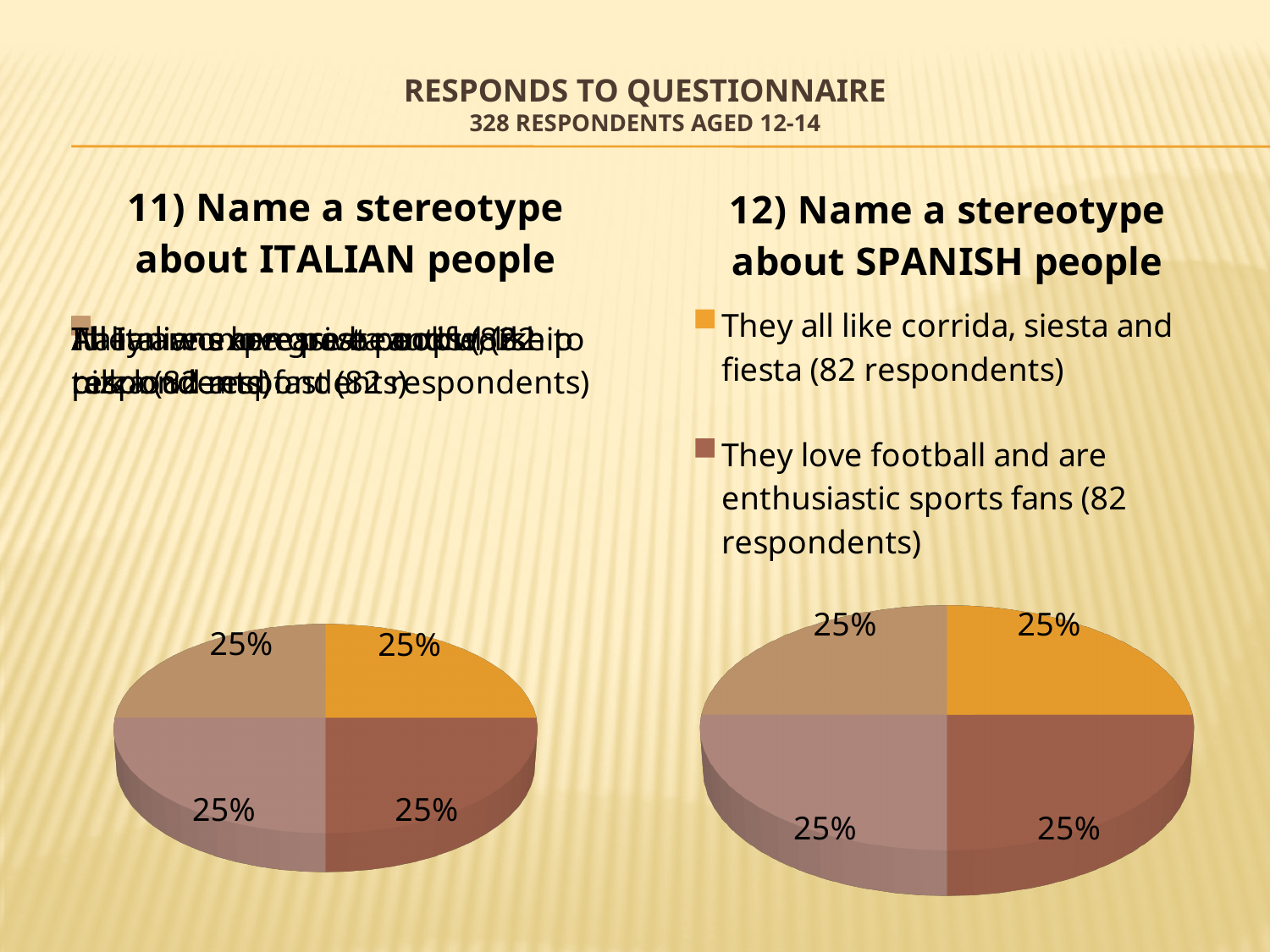
What kind of chart is shown under the title '12) Name a stereotype about SPANISH people'? pie chart What kind of chart is shown under the title '11) Name a stereotype about ITALIAN people'? pie chart In the chart '12) Name a stereotype about SPANISH people', which is larger, the orange slice or the dark brown slice? They are equal In the chart '12) Name a stereotype about SPANISH people', what share of the pie is the slice for 'They all like corrida, siesta and fiesta (82 respondents)'? 25% In the chart '12) Name a stereotype about SPANISH people', how many slices does the pie have? 4 In the chart '11) Name a stereotype about ITALIAN people', how many slices does the pie have? 4 In the chart '12) Name a stereotype about SPANISH people', what share of the pie is the slice for 'They love football and are enthusiastic sports fans (82 respondents)'? 25% What is the title of the pie chart on the right side of the slide? 12) Name a stereotype about SPANISH people In the chart '11) Name a stereotype about ITALIAN people', what percentage is shown on the orange slice? 25% In the chart '11) Name a stereotype about ITALIAN people', do all four slices have the same percentage? Yes In the chart '12) Name a stereotype about SPANISH people', what percentage is shown on the dark brown slice at the bottom right? 25% In the chart '12) Name a stereotype about SPANISH people', how many respondents are listed for 'They all like corrida, siesta and fiesta'? 82 respondents